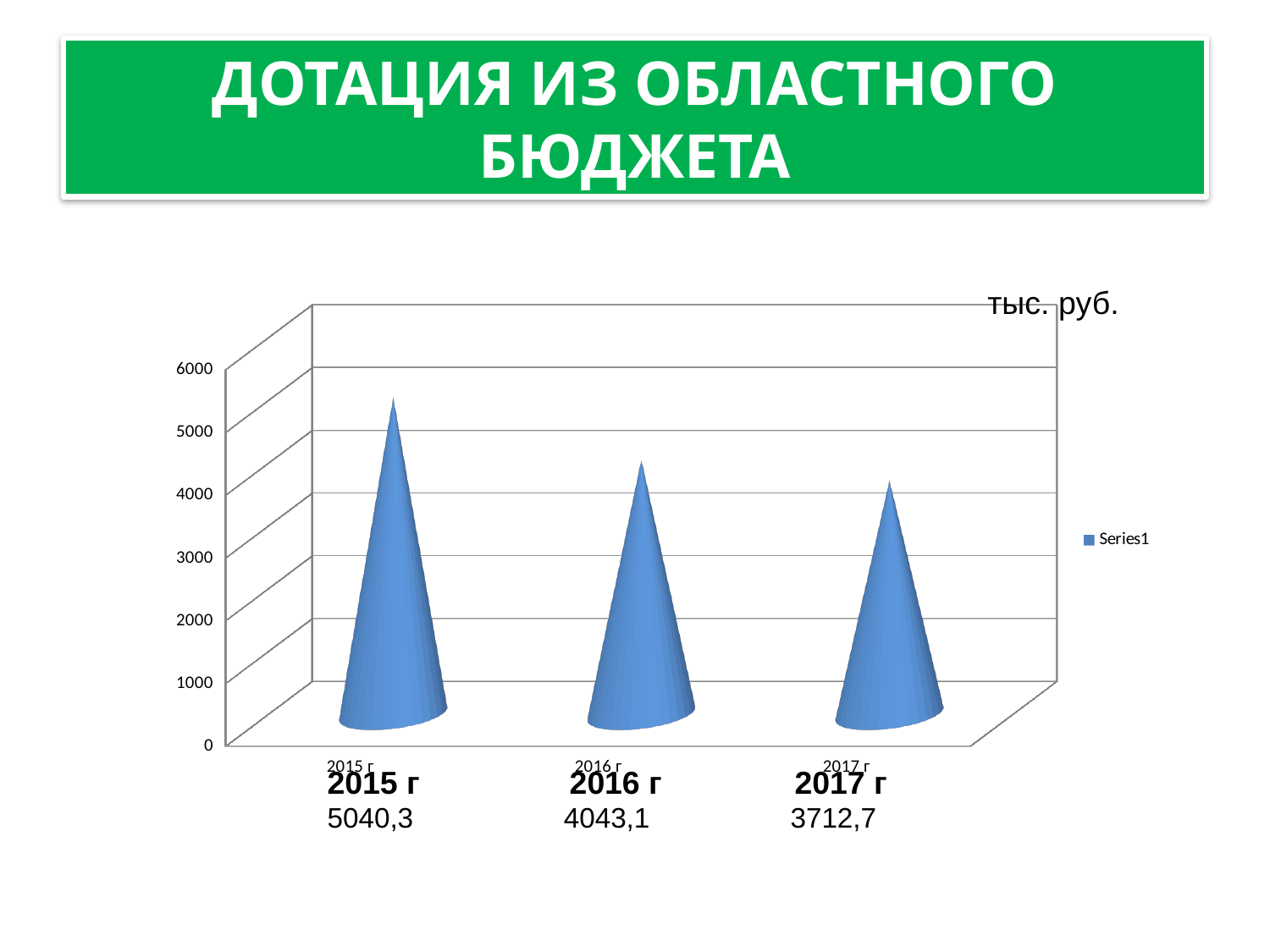
What unit is indicated for the chart values? тыс. руб. How many categories are shown on the chart? 3 What is the value for 2016 г? 4043,1 Which year has the lowest value? 2017 г Which is larger, the value for 2016 г or the value for 2017 г? 2016 г Do the values rise or fall from 2015 г to 2017 г? fall What is the value for 2015 г? 5040,3 Is the value for 2015 г greater or less than 5000? greater What is the difference between the values for 2015 г and 2016 г? 997,2 What is the value for 2017 г? 3712,7 Which year has the highest value? 2015 г What is the difference between the values for 2016 г and 2017 г? 330,4